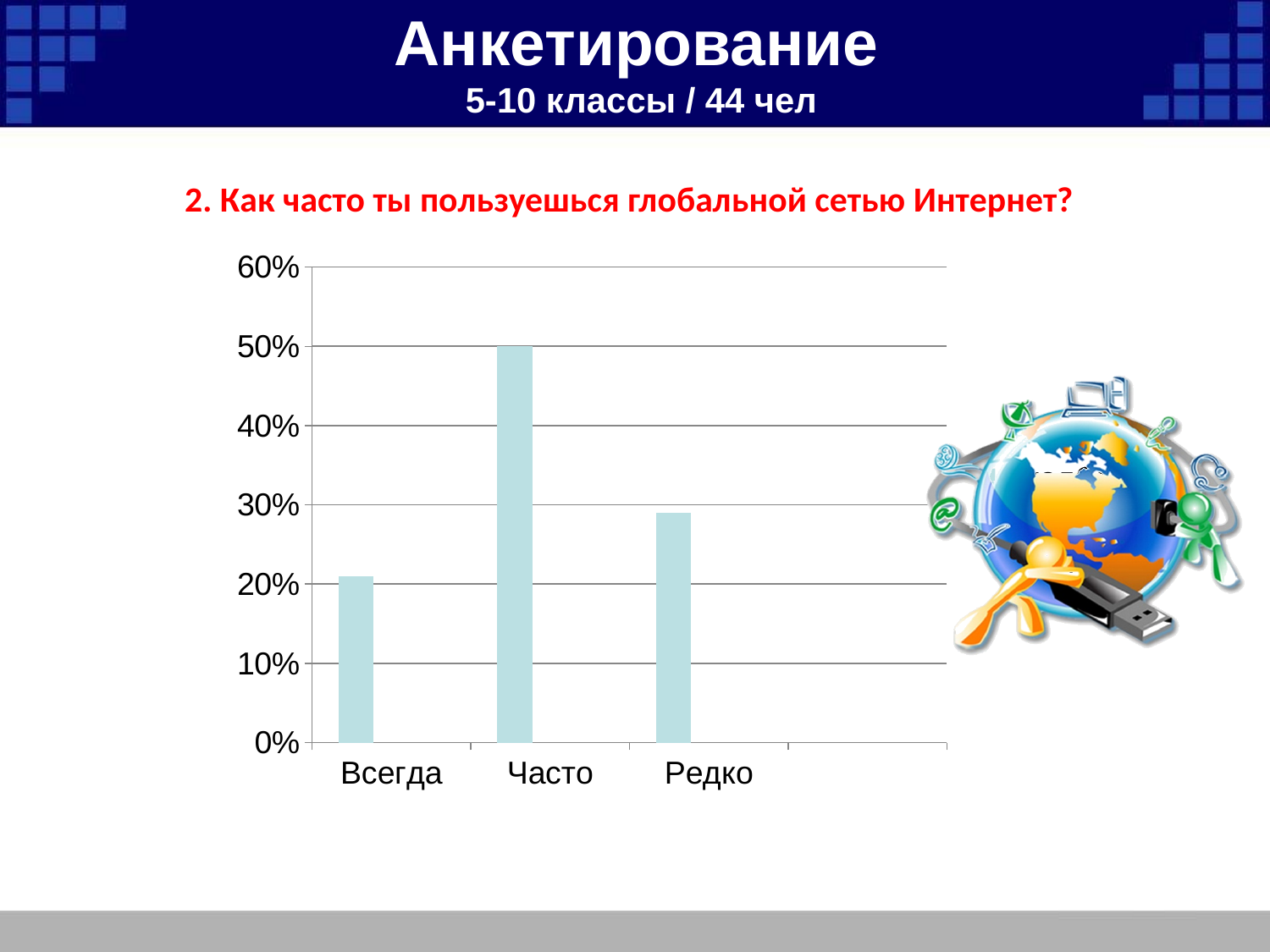
What is the value for Часто? 50% Is the value for Редко greater or less than 20%? greater What survey question does the chart illustrate? 2. Как часто ты пользуешься глобальной сетью Интернет? Which category has the lowest bar? Всегда How many categories are shown on the x axis of the chart? 3 What is the highest value shown on the y axis of the chart? 60% Is the value for Всегда greater or less than 30%? less Which is larger, the value for Редко or the value for Всегда? Редко Is the value for Часто greater or less than 40%? greater Which is larger, the value for Часто or the value for Редко? Часто Which category has the highest bar? Часто What kind of chart is shown on the slide? bar chart